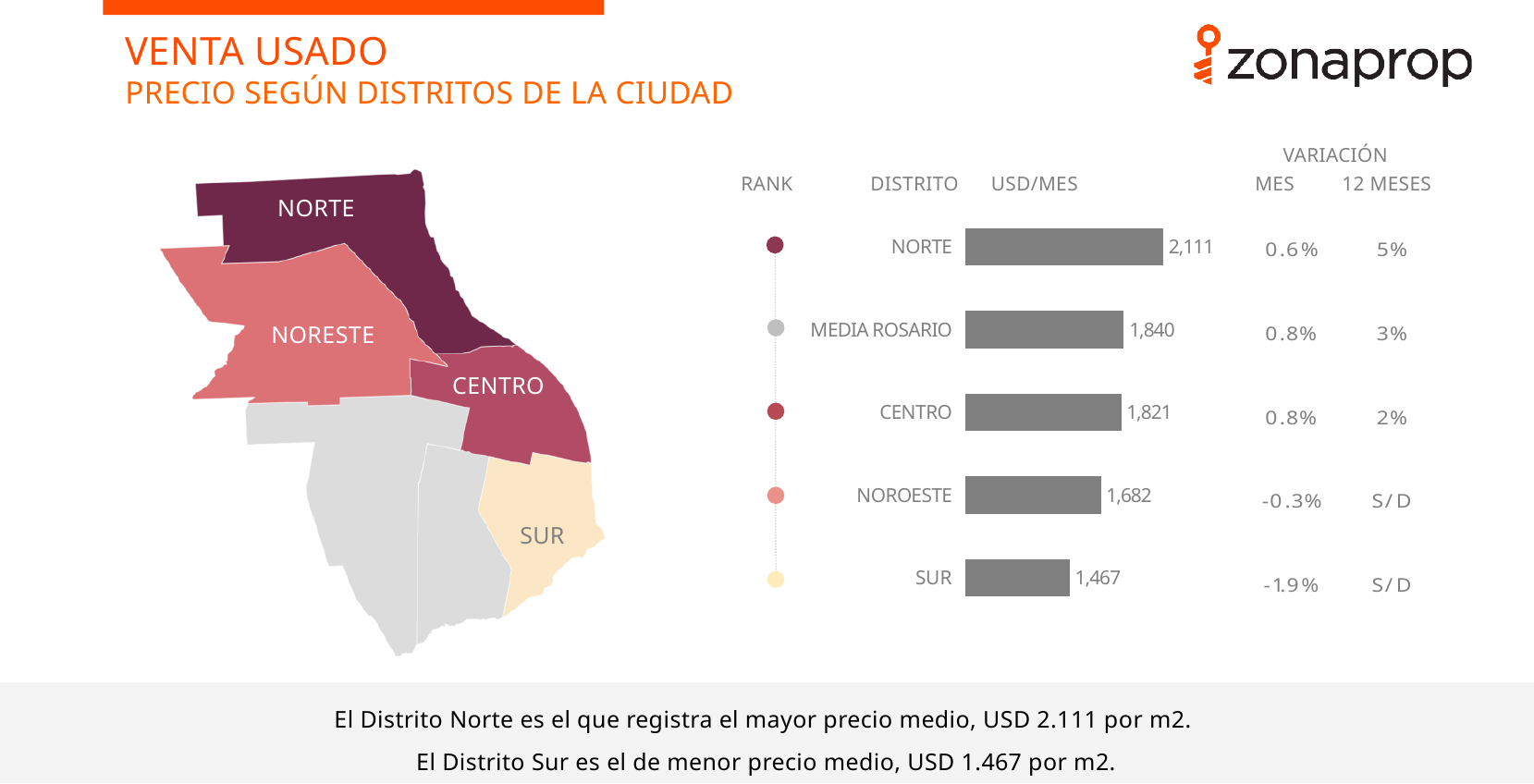
Which district has the lowest USD/MES value in the bar chart? SUR What is the USD/MES value for MEDIA ROSARIO in the bar chart? 1,840 What is the USD/MES value for NOROESTE in the bar chart? 1,682 What is the difference in USD/MES between MEDIA ROSARIO and CENTRO? 19 Which has a larger USD/MES value, CENTRO or NOROESTE? CENTRO What kind of chart is used to show the USD/MES values? Bar chart How many districts are shown in the bar chart? 5 What is the USD/MES value for SUR in the bar chart? 1,467 What is the USD/MES value for NORTE in the bar chart? 2,111 What is the difference in USD/MES between NORTE and SUR? 644 Do the USD/MES values increase or decrease going down the list from NORTE to SUR? Decrease Which district has the highest USD/MES value in the bar chart? NORTE